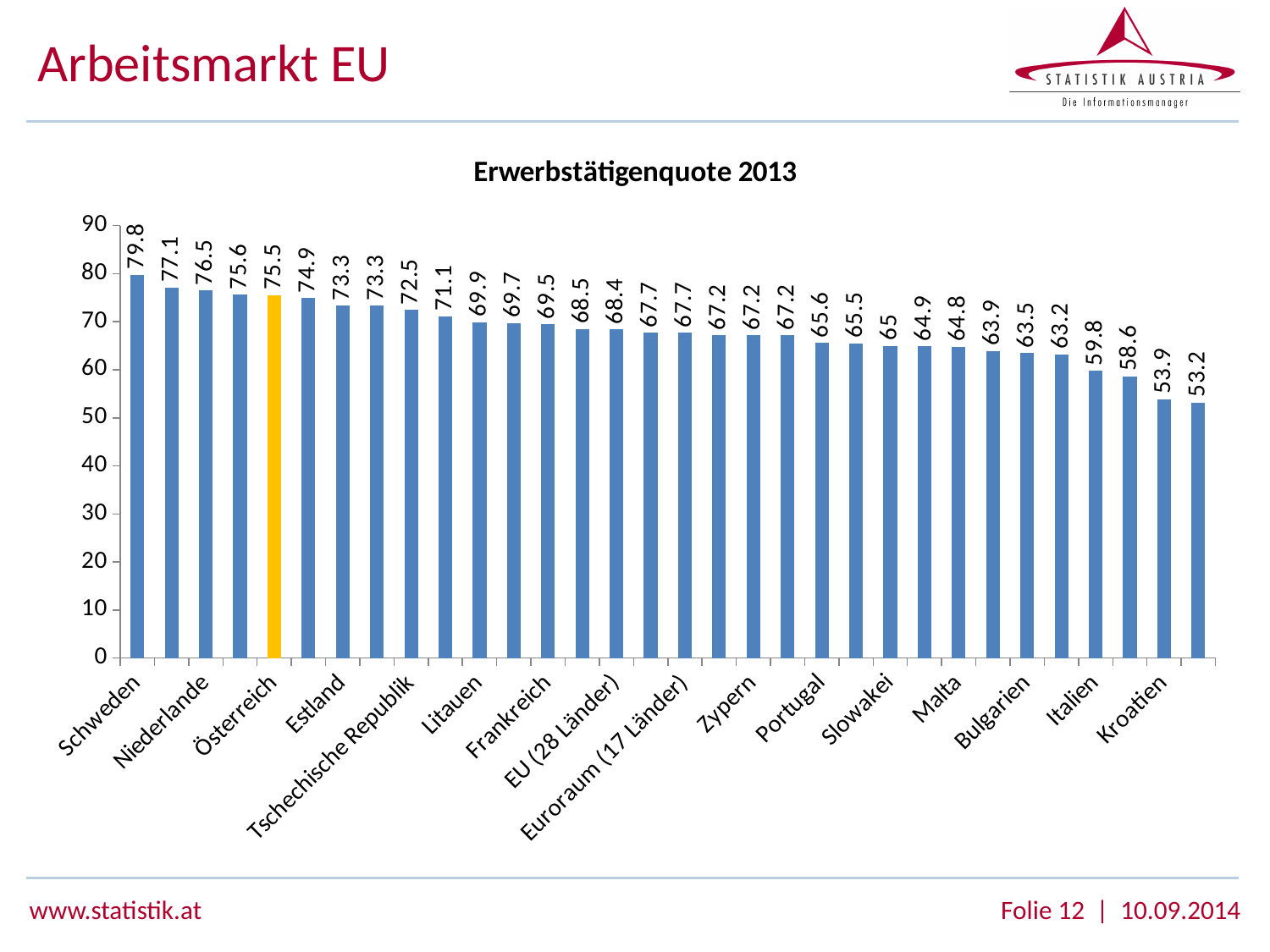
What is the value for Euroraum (17 Länder)? 67.7 What is the difference between the values for Schweden and Österreich? 4.3 Which country's bar is highlighted in yellow? Österreich What kind of chart is shown? bar chart What is the lowest value shown on the chart? 53.2 Do the values rise or fall from left to right along the x axis? fall What is the value for Schweden? 79.8 Which labelled country has the highest value? Schweden What is the value for EU (28 Länder)? 68.4 Which is larger, the value for Niederlande or the value for Estland? Niederlande Is the value for Litauen greater or less than 60? greater What is the value for Österreich? 75.5